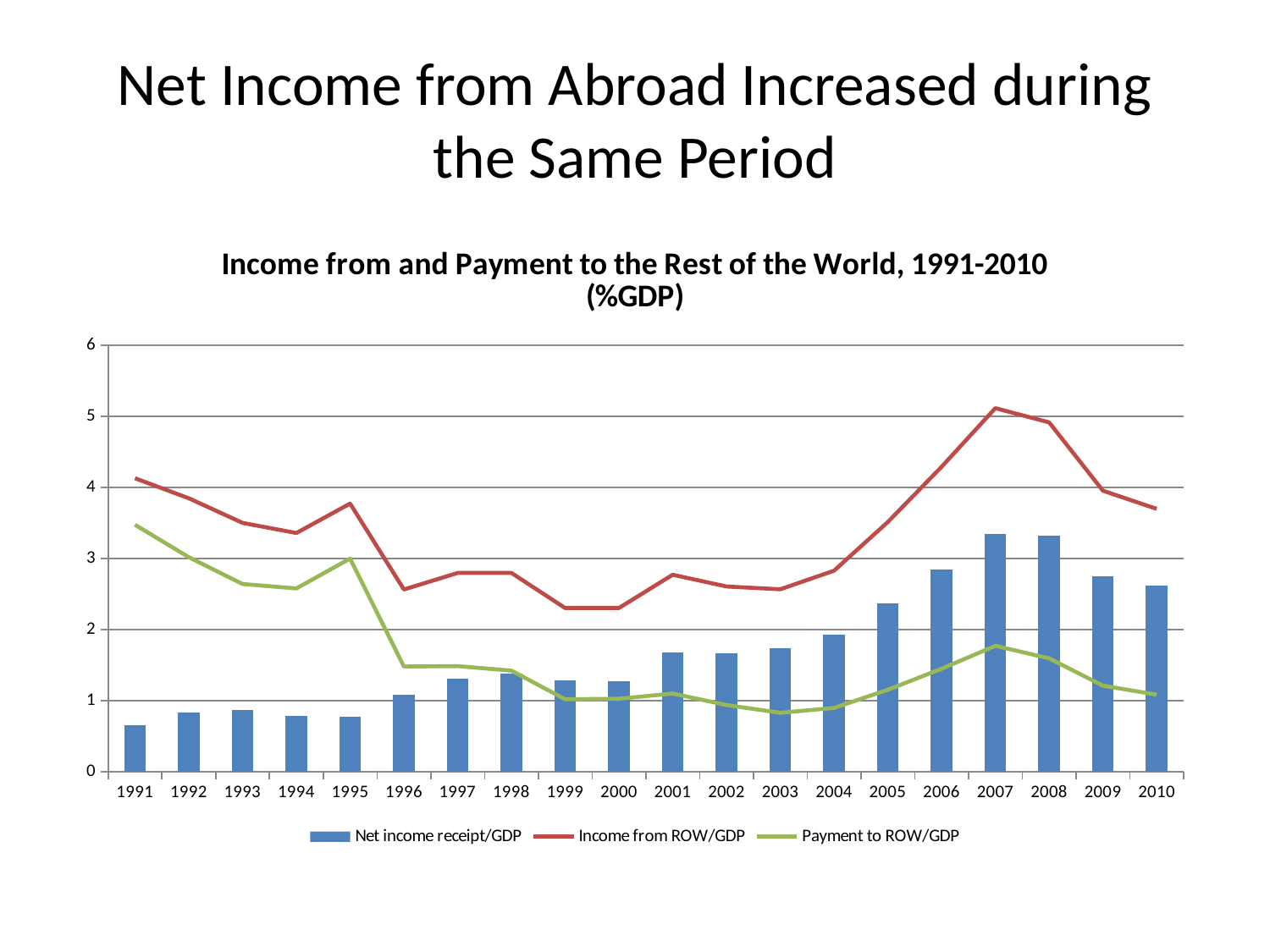
In which year is Net income receipt/GDP lowest? 1991 In which year is Payment to ROW/GDP highest? 1991 Is the value of Income from ROW/GDP in 2007 greater or less than 5? greater How many series does the legend list? 3 How many years are shown on the x axis? 20 In which year is Income from ROW/GDP highest? 2007 Does Net income receipt/GDP generally rise or fall from 1991 to 2007? rise Which is larger in 2010: Net income receipt/GDP or Payment to ROW/GDP? Net income receipt/GDP Is the value of Payment to ROW/GDP in 1996 greater or less than 2? less What type of chart is shown on the slide? A combined bar and line chart Is the value of Net income receipt/GDP in 2005 greater or less than 2? greater